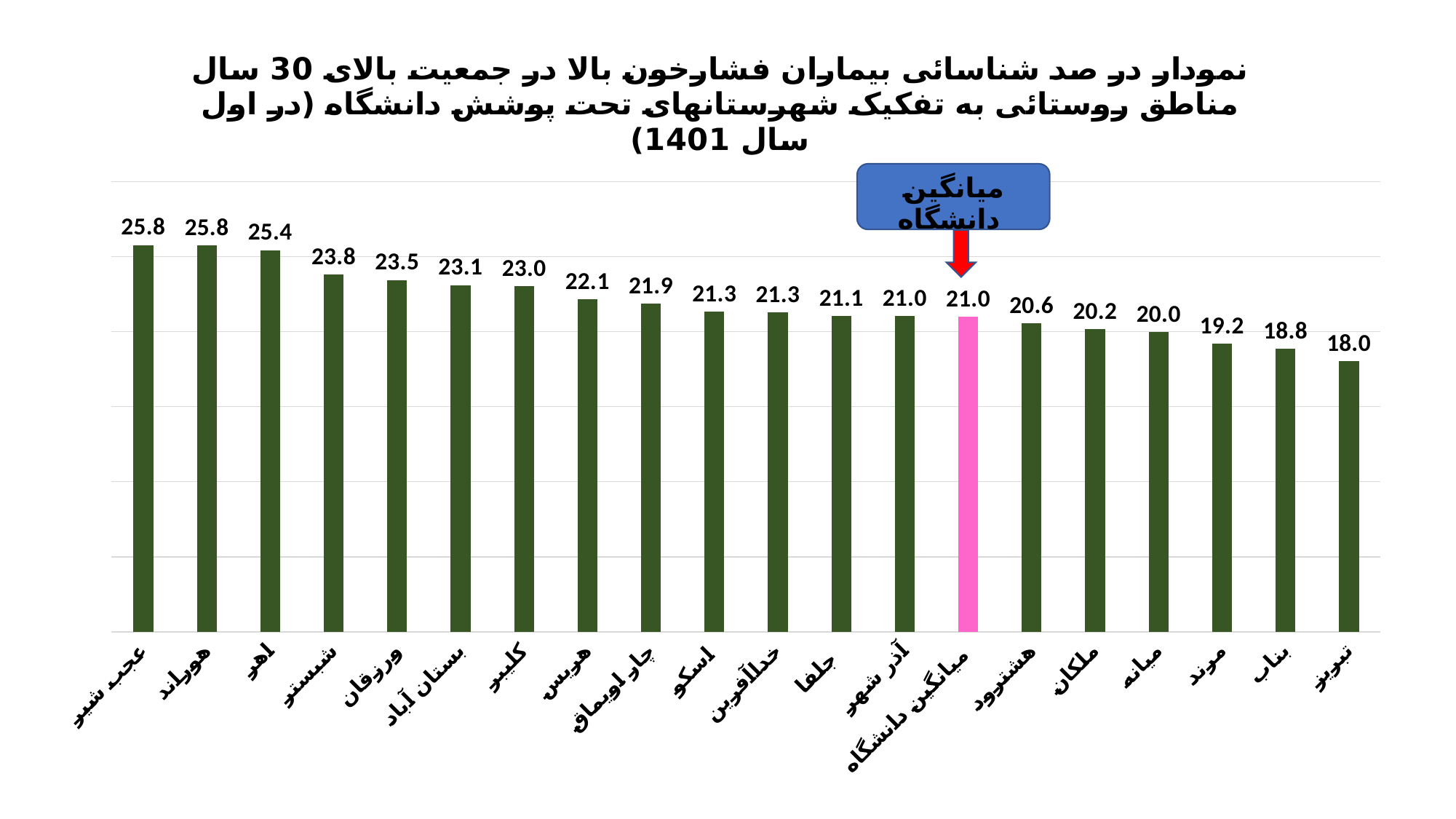
What is the value for میانگین دانشگاه (the highlighted pink bar)? 21.0 Which bar is highlighted in pink rather than dark green? میانگین دانشگاه Which has a larger value, کلیبر or مرند? کلیبر What type of chart is shown on the slide? bar chart Do the values generally rise or fall from left to right along the x axis? fall How many bars are plotted in the chart? 20 What is the difference between the values for عجب شیر and تبریز? 7.8 What is the value for تبریز? 18.0 What is the value for اهر? 25.4 What is the difference between the values for شبستر and بناب? 5.0 What is the value for هشترود? 20.6 Which category has the lowest value? تبریز